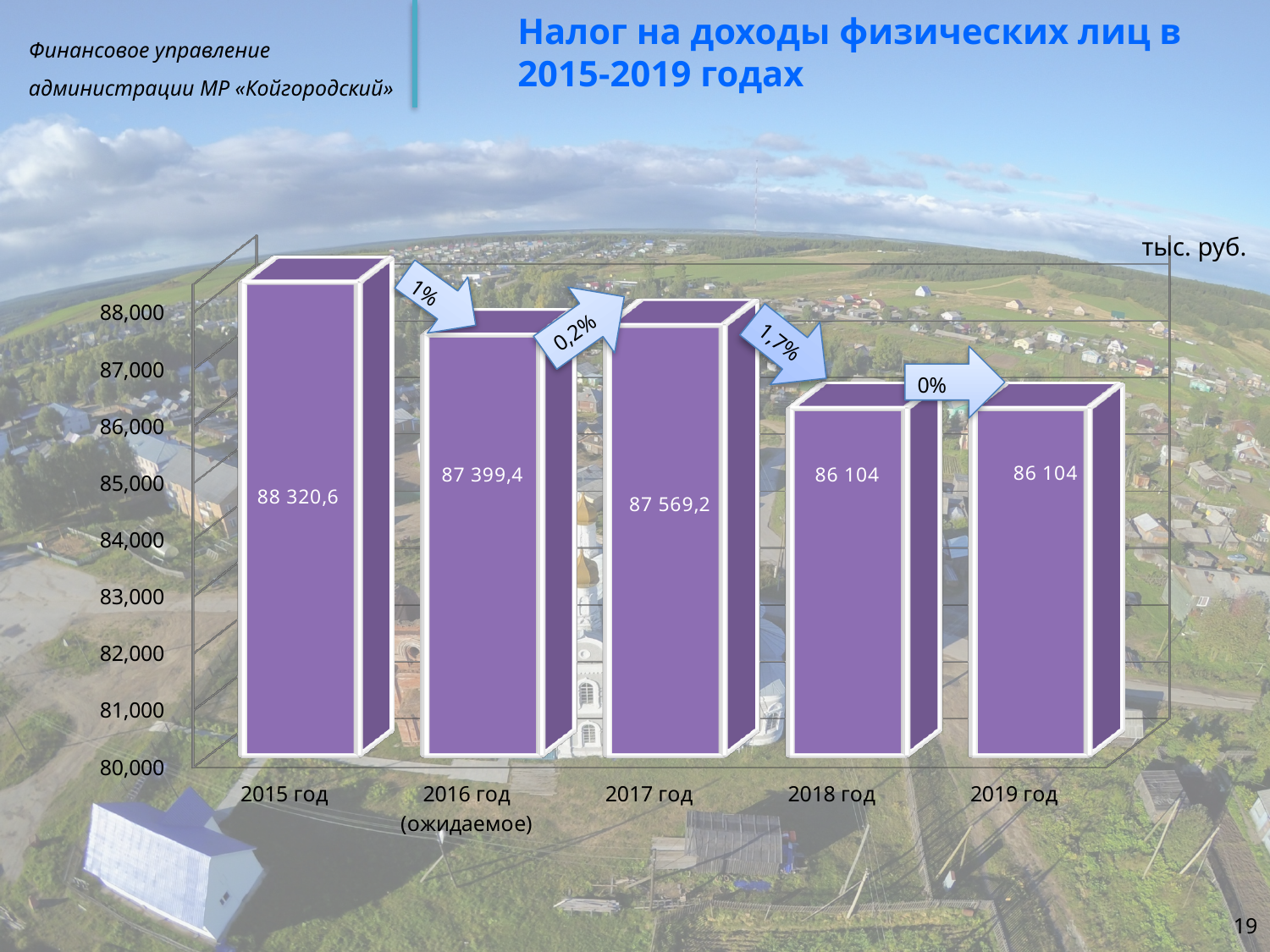
What is the value for 2018 год? 86 104 Which year has the highest value? 2015 год Which is larger, the value for 2016 год (ожидаемое) or the value for 2017 год? 2017 год What is the difference between the values for 2017 год and 2018 год? 1 465,2 What unit is indicated for the values on the chart? тыс. руб. What is the value for 2017 год? 87 569,2 What kind of chart is shown on the slide? bar chart Is the value for 2015 год greater or less than 88,000? greater How many years are shown on the chart? 5 What is the value for 2016 год (ожидаемое)? 87 399,4 What is the difference between the values for 2015 год and 2016 год (ожидаемое)? 921,2 What is the value for 2015 год? 88 320,6